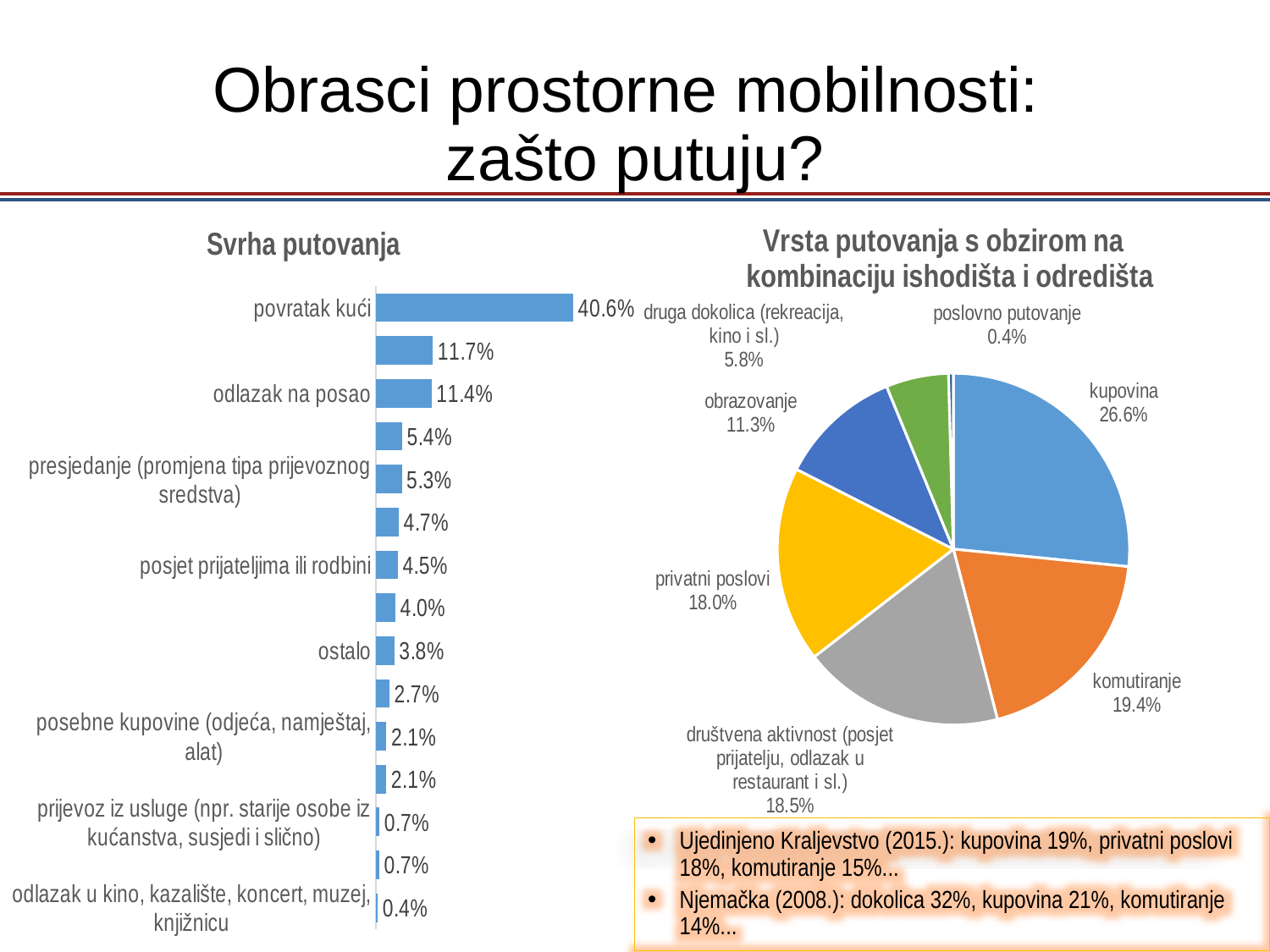
In the pie chart 'Vrsta putovanja s obzirom na kombinaciju ishodišta i odredišta', what is the share for 'kupovina'? 26.6% In the 'Svrha putovanja' bar chart, what is the value for 'odlazak na posao'? 11.4% What type of chart is 'Svrha putovanja'? bar chart In the pie chart 'Vrsta putovanja s obzirom na kombinaciju ishodišta i odredišta', which is larger: 'komutiranje' or 'obrazovanje'? komutiranje In the 'Svrha putovanja' bar chart, what is the value for 'posjet prijateljima ili rodbini'? 4.5% In the 'Svrha putovanja' bar chart, which category has the lowest value? odlazak u kino, kazalište, koncert, muzej, knjižnicu In the 'Svrha putovanja' bar chart, what is the difference between 'povratak kući' and 'odlazak na posao'? 29.2% In the pie chart 'Vrsta putovanja s obzirom na kombinaciju ishodišta i odredišta', which category has the smallest slice? poslovno putovanje How many slices does the pie chart 'Vrsta putovanja s obzirom na kombinaciju ishodišta i odredišta' have? 7 In the 'Svrha putovanja' bar chart, which category has the highest value? povratak kući In the 'Svrha putovanja' bar chart, how many bars are plotted? 15 In the 'Svrha putovanja' bar chart, what is the value for 'povratak kući'? 40.6%